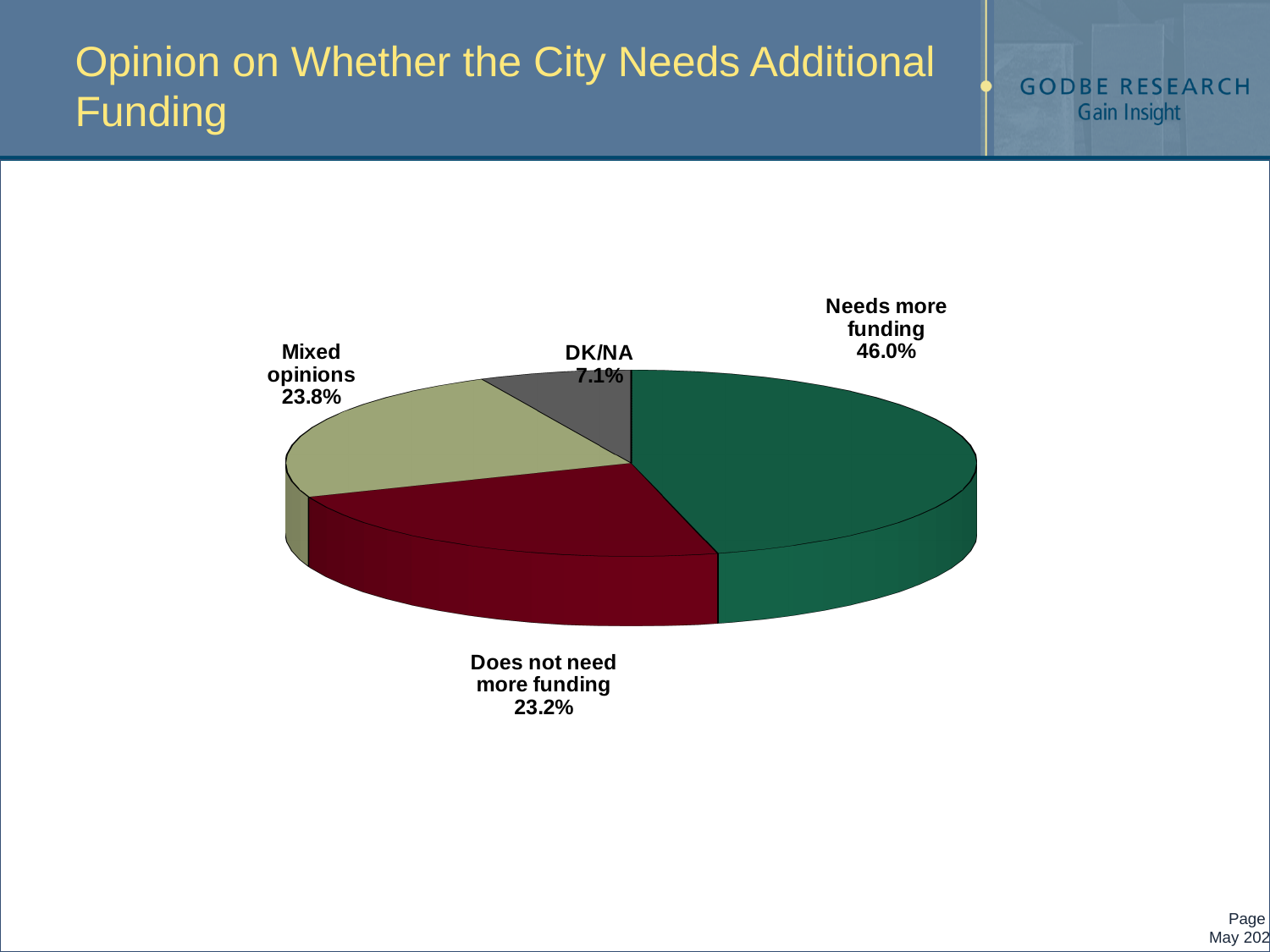
What type of chart is shown on the slide? Pie chart What is the difference in percentage points between 'Mixed opinions' and 'DK/NA'? 16.7 What percentage of respondents answered DK/NA? 7.1% Which is larger: the share for 'Needs more funding' or the share for 'Mixed opinions'? Needs more funding What is the title of the slide containing the chart? Opinion on Whether the City Needs Additional Funding What percentage of respondents said the city does not need more funding? 23.2% What percentage of respondents said the city needs more funding? 46.0% How many categories are shown in the pie chart? 4 Which response category has the smallest share of the pie? DK/NA What percentage of respondents had mixed opinions? 23.8% Which response category has the largest share of the pie? Needs more funding What is the difference in percentage points between 'Needs more funding' and 'Does not need more funding'? 22.8